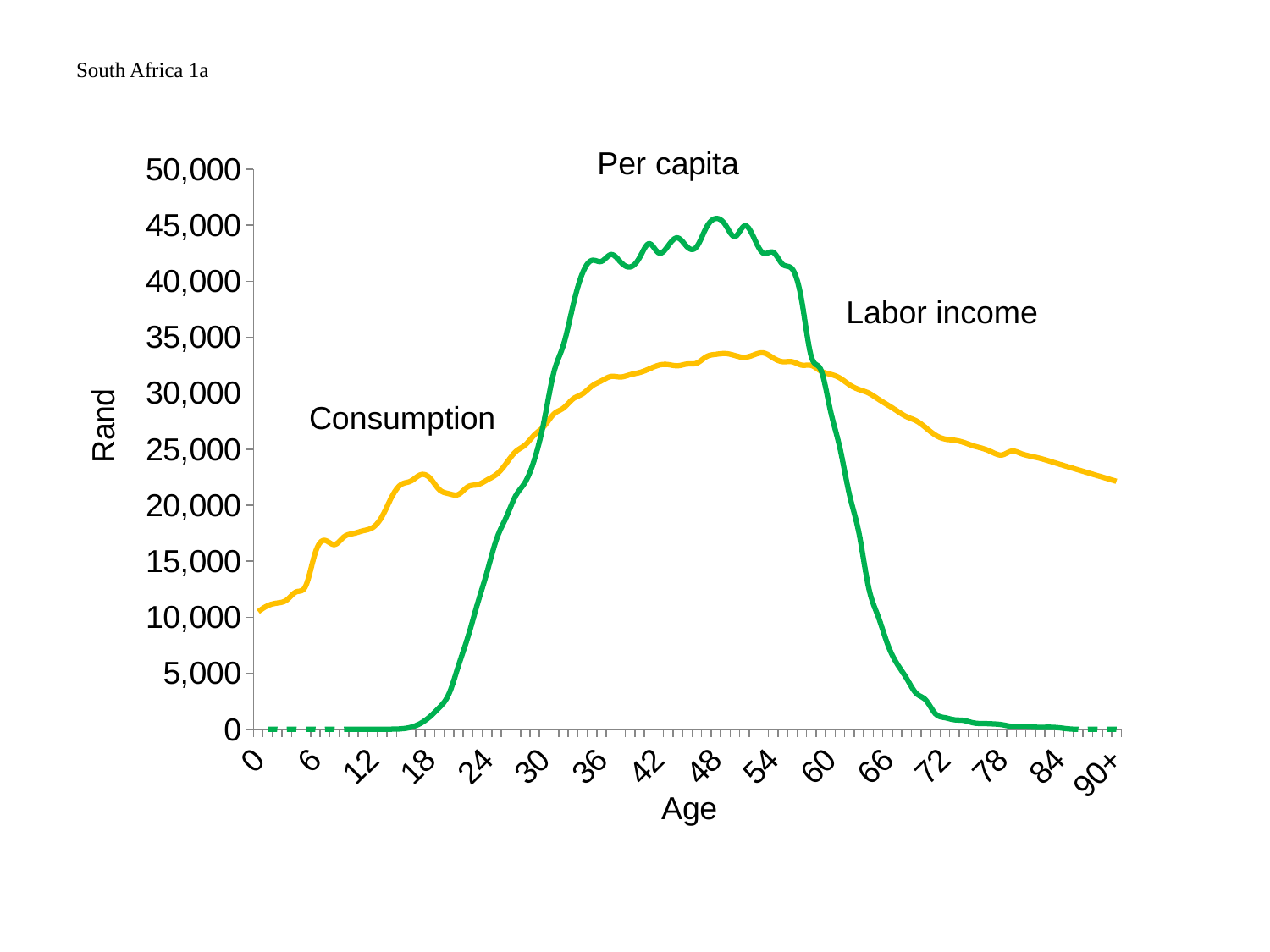
At age 48, which series has the larger value, Consumption or Labor income? Labor income Does the Labor income line rise or fall between age 60 and age 72? fall What kind of chart is shown on the slide? line chart What is the label on the vertical axis of the chart? Rand Is the value for Labor income at age 12 greater or less than 5,000? less Does the Consumption line rise or fall between age 0 and age 30? rise What is the title of the chart? Per capita At age 78, which series has the larger value, Consumption or Labor income? Consumption Is the value for Labor income at age 48 greater or less than 40,000? greater How many data series are plotted on the chart? 2 Is the value for Consumption at age 0 greater or less than 15,000? less